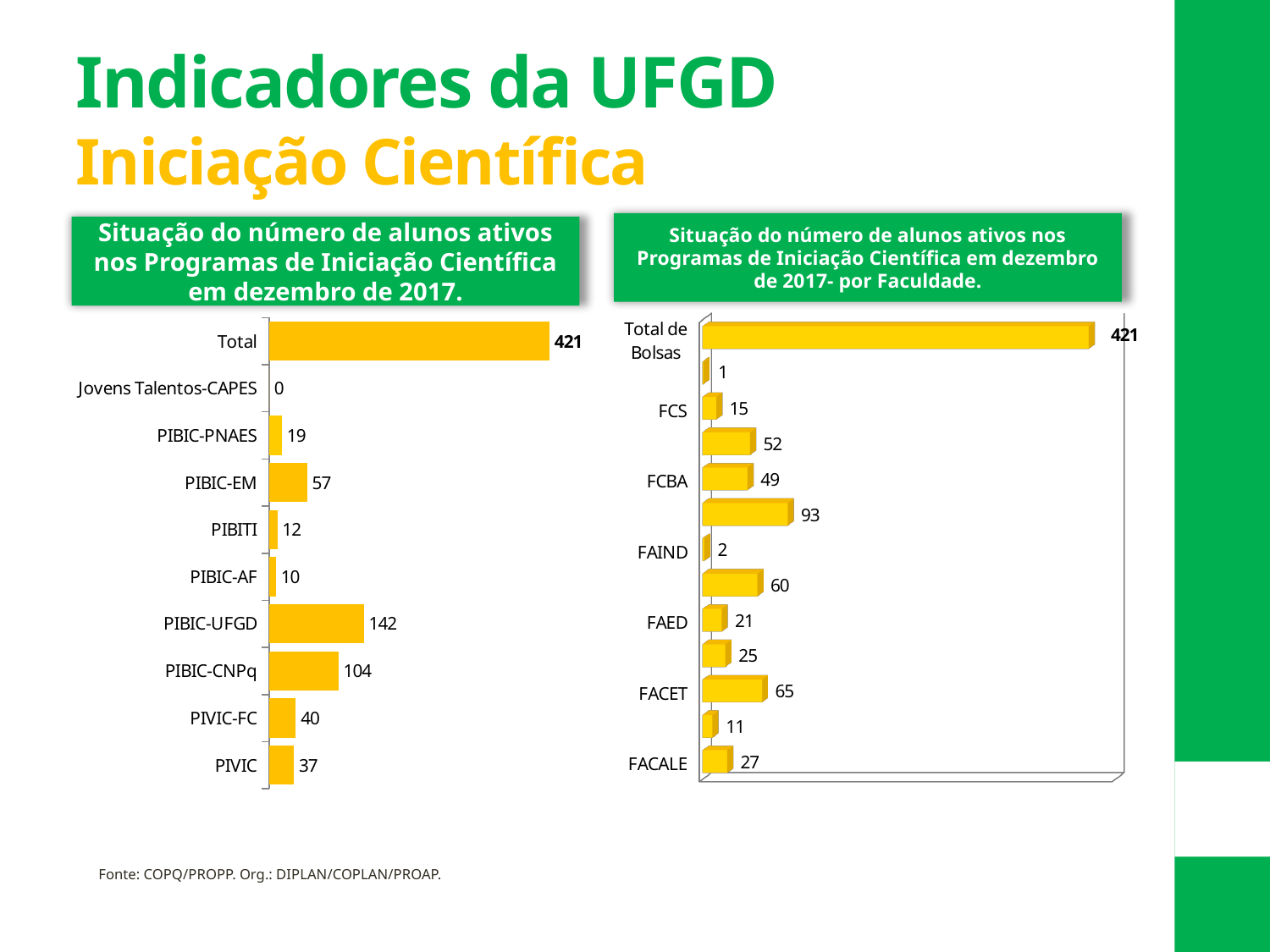
In the right chart (por Faculdade), what is the value for FAIND? 2 In the left chart, what is the difference between PIBIC-UFGD and PIBIC-CNPq? 38 In the left chart, what is the value for PIBIC-CNPq? 104 In the left chart (Situação do número de alunos ativos nos Programas de Iniciação Científica em dezembro de 2017), what is the value for PIBIC-UFGD? 142 In the right chart (por Faculdade), what is the value for FACET? 65 In the left chart, which is larger: PIVIC-FC or PIVIC? PIVIC-FC How many categories (bars) does the left chart show, including Total? 10 In the left chart, excluding the Total bar, which program has the highest number of active students? PIBIC-UFGD What type of chart is the left chart? Bar chart In the left chart, what is the value for Jovens Talentos-CAPES? 0 In the right chart (por Faculdade), what is the difference between FACALE and FAED? 6 In the left chart, which program has the lowest value? Jovens Talentos-CAPES